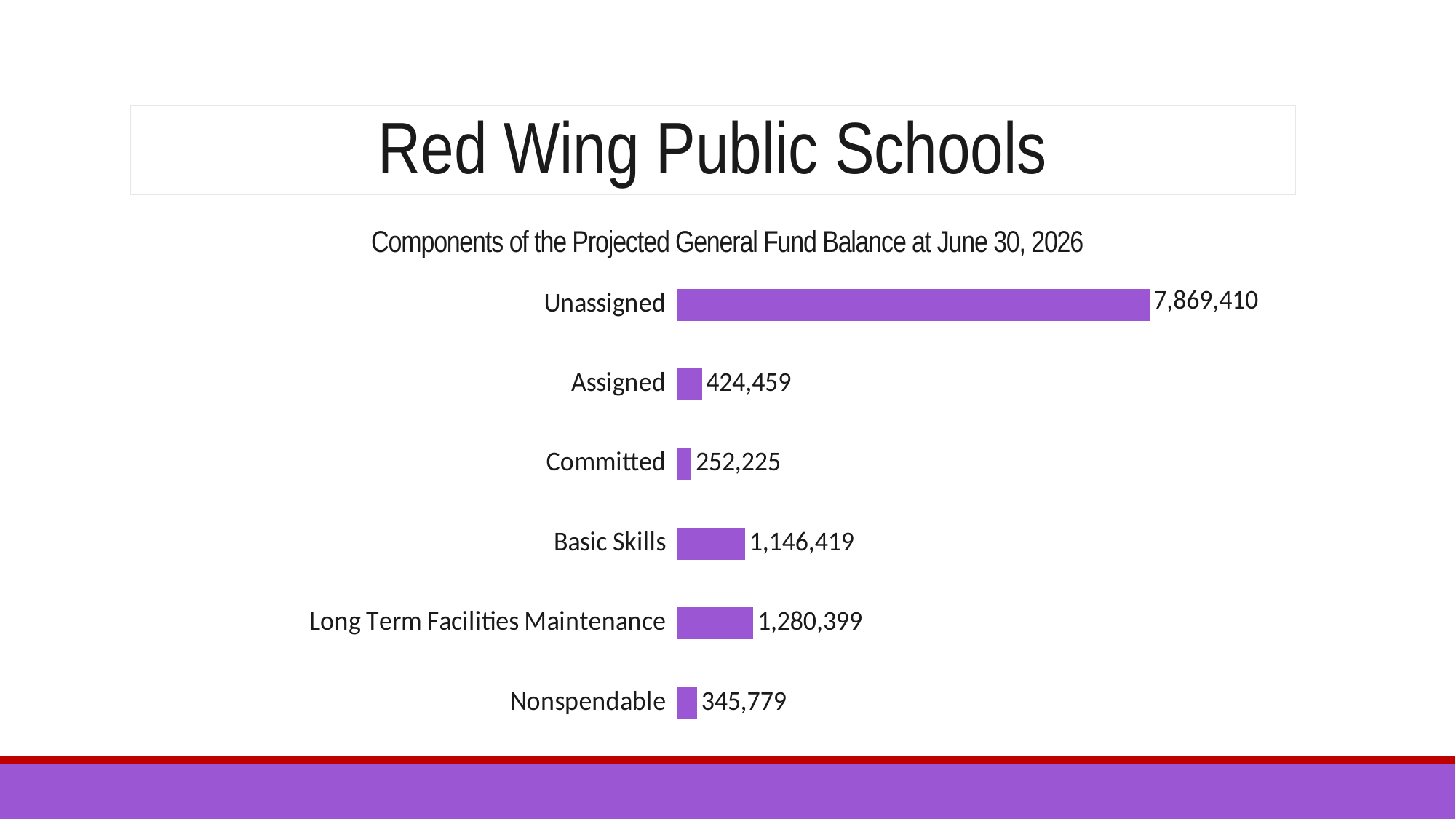
Which category has the highest value? Unassigned What kind of chart is this? Bar chart What is the value for Unassigned? 7,869,410 Which category has the lowest value? Committed What is the value for Long Term Facilities Maintenance? 1,280,399 What is the title of the chart? Components of the Projected General Fund Balance at June 30, 2026 What is the value for Basic Skills? 1,146,419 How many categories are shown in the chart? 6 What is the difference between Long Term Facilities Maintenance and Basic Skills? 133,980 What is the value for Nonspendable? 345,779 Which is larger, Assigned or Nonspendable? Assigned What is the difference between Assigned and Committed? 172,234